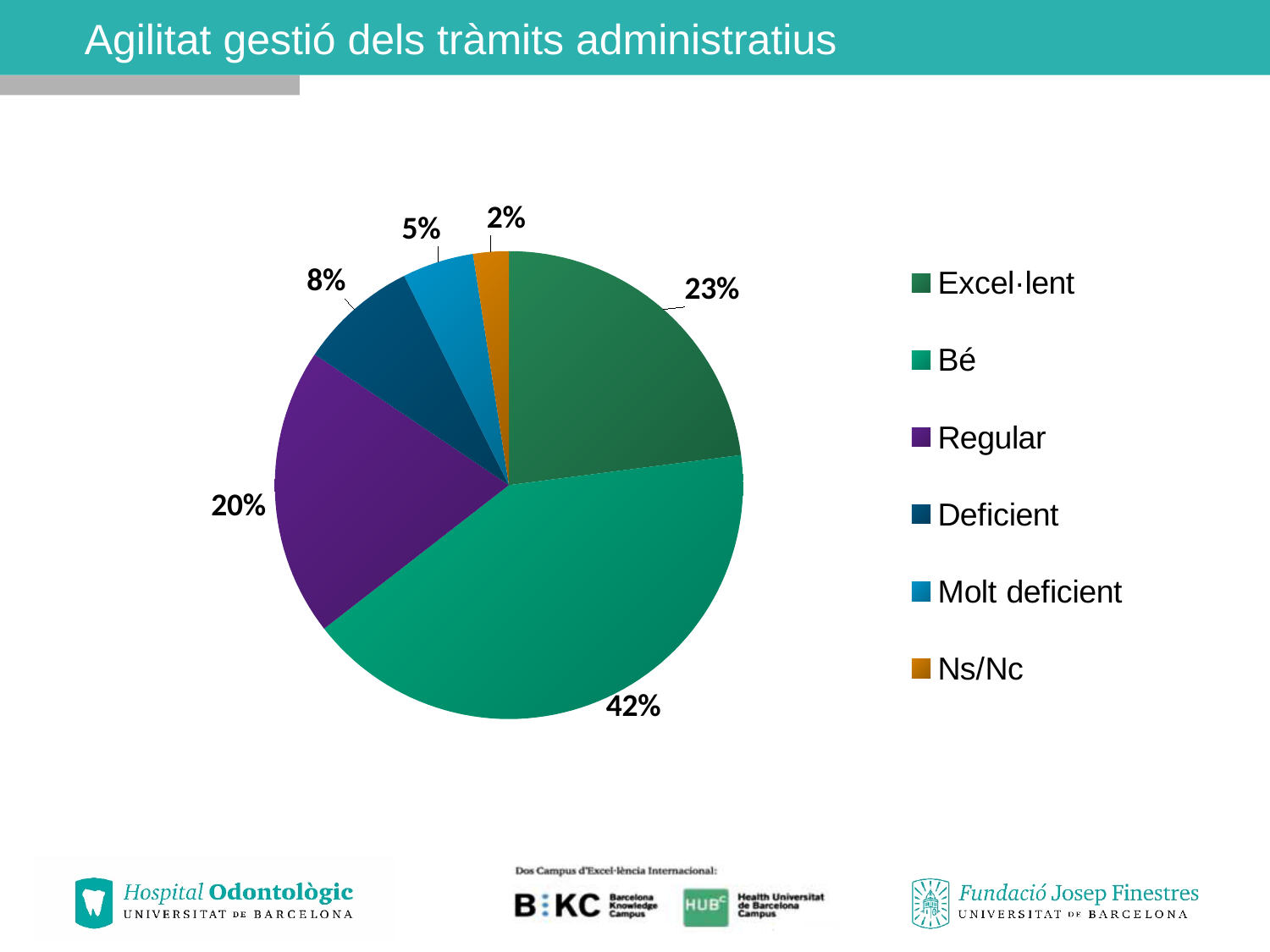
What percentage of the pie is labelled Bé? 42% Which category has the smallest slice of the pie? Ns/Nc What is the difference in percentage points between the Bé slice and the Excel·lent slice? 19 What kind of chart is shown on the slide? Pie chart What is the title of the slide containing the chart? Agilitat gestió dels tràmits administratius Which category has the largest slice of the pie? Bé What percentage of the pie is labelled Molt deficient? 5% Which slice is larger, Regular or Deficient? Regular What percentage of the pie is labelled Excel·lent? 23% How many slices does the pie chart have? 6 What percentage of the pie is labelled Regular? 20% What percentage of the pie is labelled Deficient? 8%